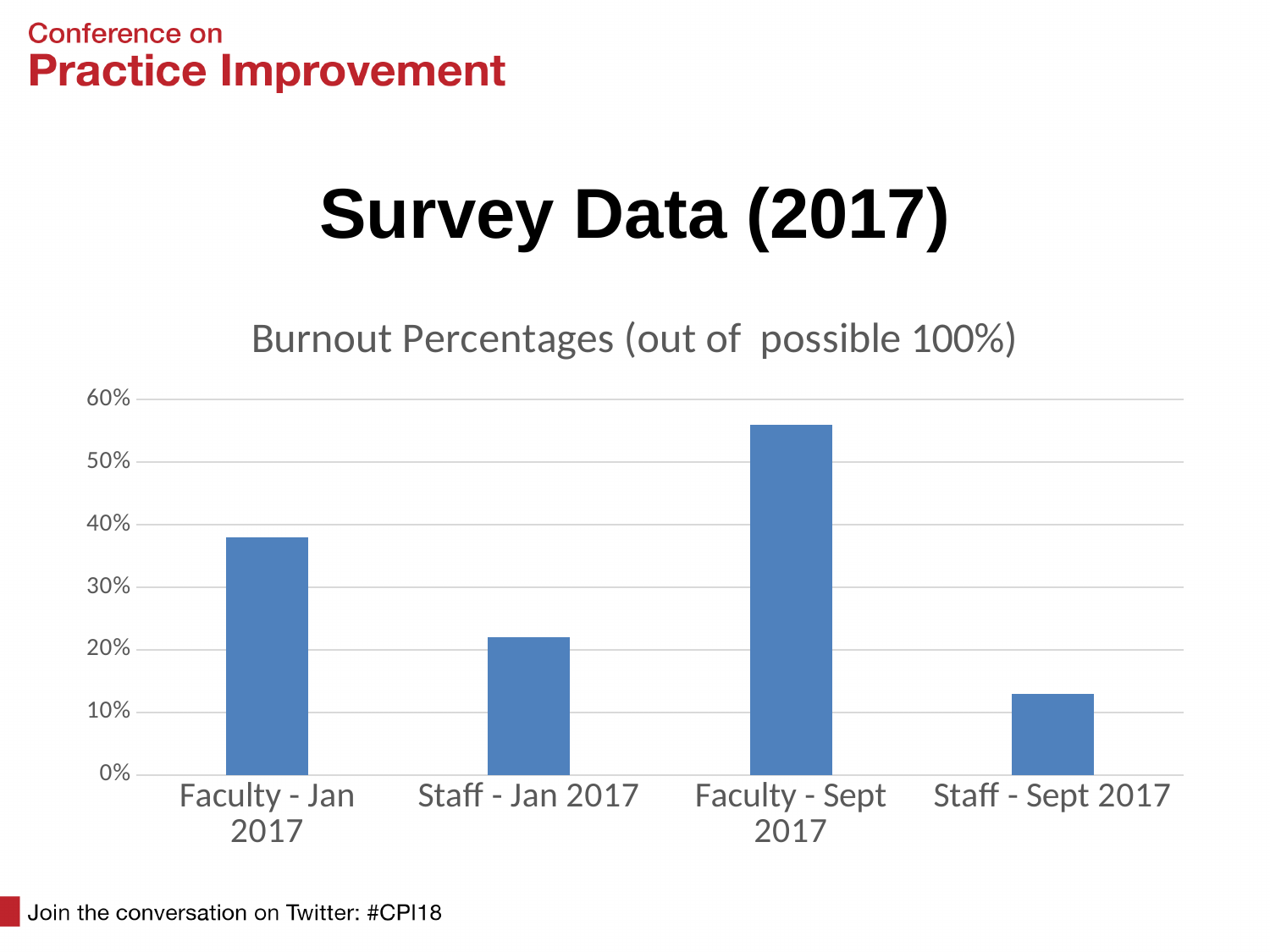
Which category has the highest burnout percentage? Faculty - Sept 2017 Is the value for Staff - Sept 2017 greater or less than 20%? less Which category has the lowest burnout percentage? Staff - Sept 2017 Which is larger, the value for Staff - Jan 2017 or Staff - Sept 2017? Staff - Jan 2017 Is the value for Faculty - Sept 2017 greater or less than 50%? greater Is the value for Faculty - Jan 2017 greater or less than 40%? less What is the highest value shown on the vertical axis? 60% Which is larger, the value for Faculty - Jan 2017 or Staff - Jan 2017? Faculty - Jan 2017 How many categories are plotted in the chart? 4 What is the title of the chart? Burnout Percentages (out of possible 100%) What type of chart is shown on the slide? bar chart